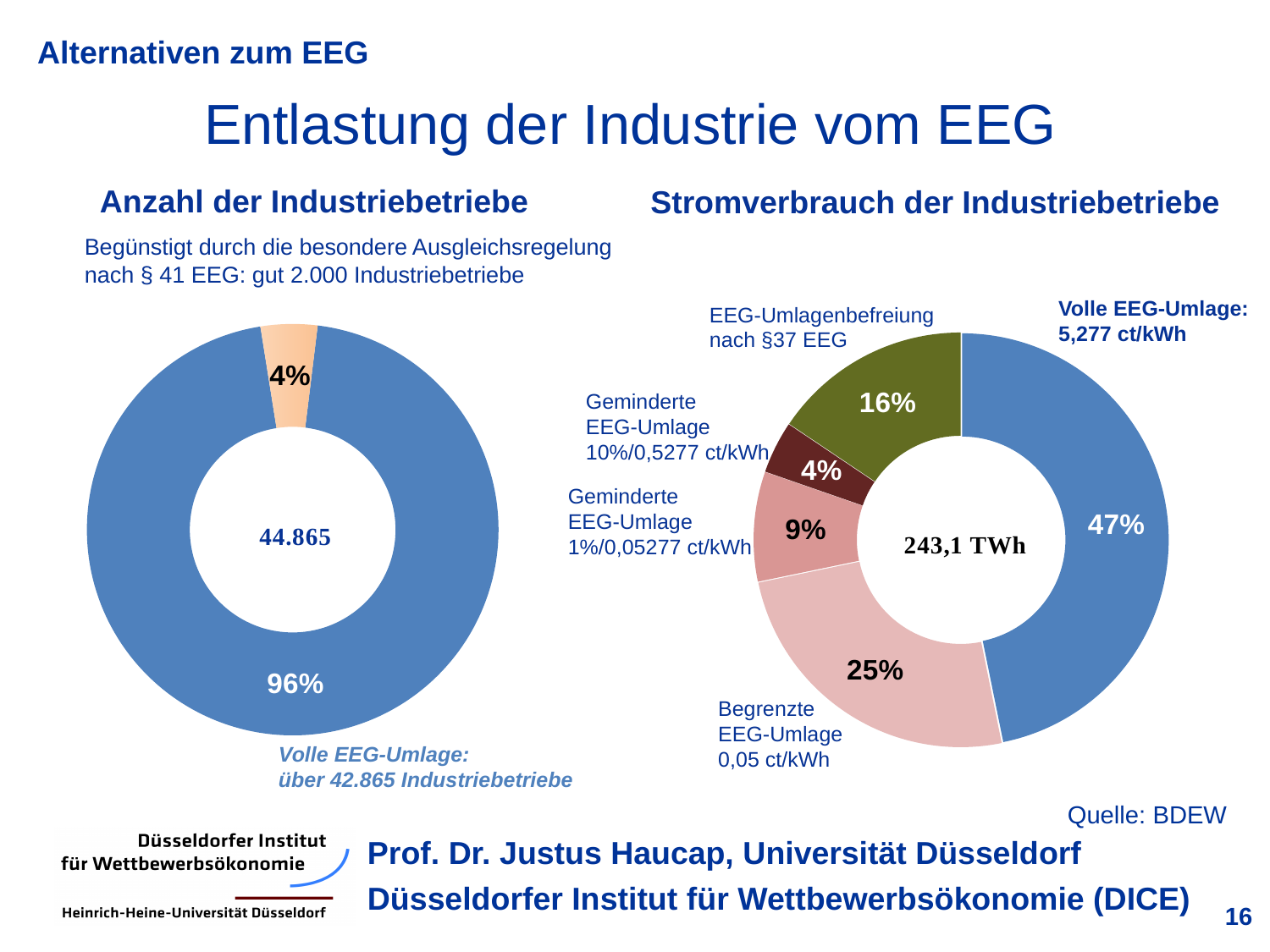
How many segments does the 'Anzahl der Industriebetriebe' chart have? 2 What number is printed in the centre of the 'Anzahl der Industriebetriebe' chart? 44.865 In the 'Anzahl der Industriebetriebe' chart, what share is labelled for the large blue segment? 96% In the 'Stromverbrauch der Industriebetriebe' chart, which segment has the largest share? Volle EEG-Umlage (47%) In the 'Stromverbrauch der Industriebetriebe' chart, what share is shown for 'EEG-Umlagenbefreiung nach §37 EEG'? 16% How many segments does the 'Stromverbrauch der Industriebetriebe' chart have? 5 In the 'Stromverbrauch der Industriebetriebe' chart, which segment has the smallest share? Geminderte EEG-Umlage 10%/0,5277 ct/kWh (4%) In the 'Stromverbrauch der Industriebetriebe' chart, what share is shown for 'Begrenzte EEG-Umlage 0,05 ct/kWh'? 25% What kind of chart is used for 'Anzahl der Industriebetriebe'? Donut (pie) chart In the 'Stromverbrauch der Industriebetriebe' chart, what is the difference between the 'Volle EEG-Umlage' share and the 'Begrenzte EEG-Umlage' share? 22 percentage points